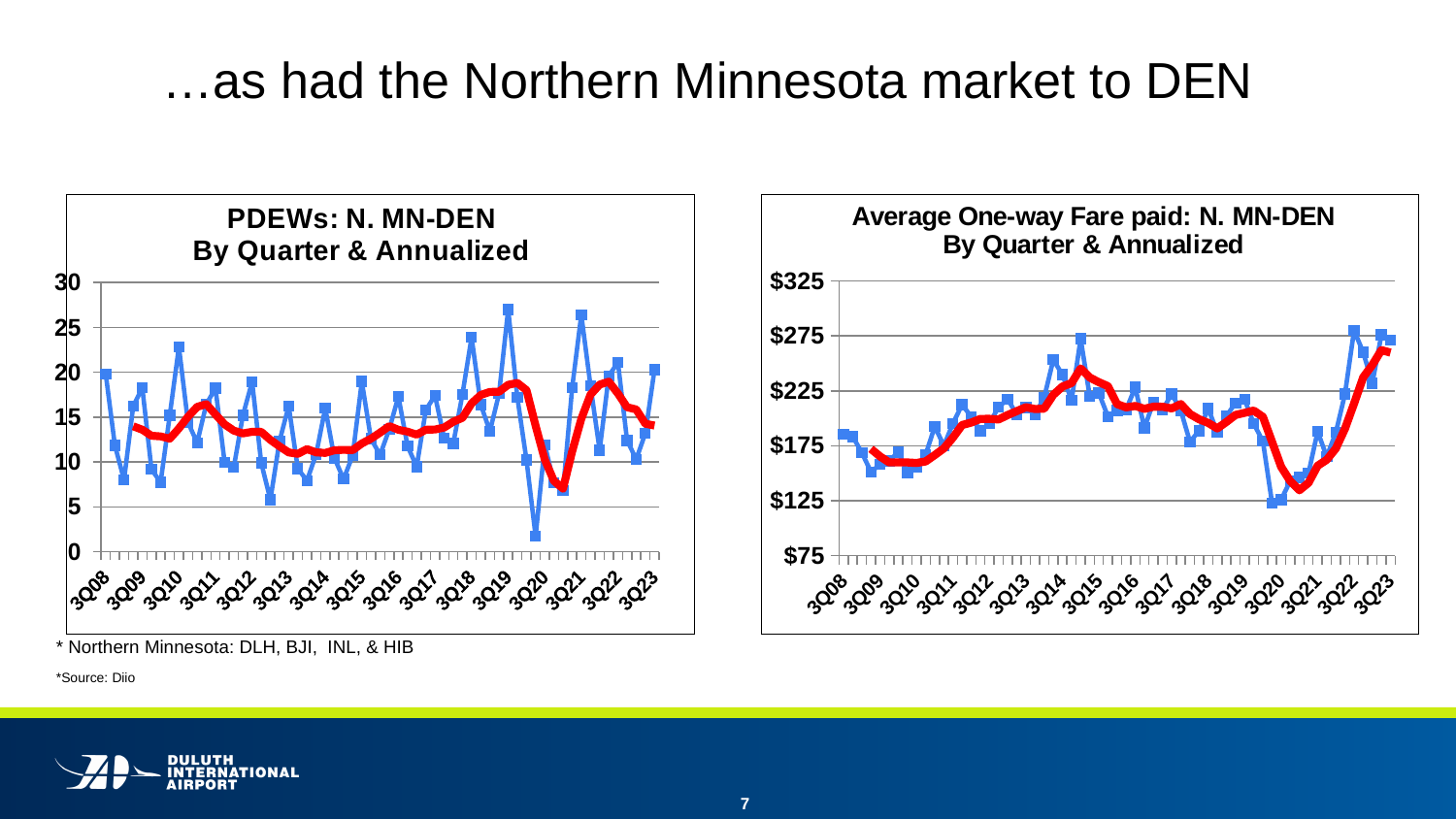
In the 'PDEWs: N. MN-DEN' chart, is the highest quarterly value greater or less than 25? greater What kind of chart is the 'PDEWs: N. MN-DEN By Quarter & Annualized' chart? line chart In the 'PDEWs: N. MN-DEN' chart, is the lowest quarterly value greater or less than 5? less In the 'Average One-way Fare paid' chart, does the fare rise or fall between 3Q20 and 3Q23? rise In the 'Average One-way Fare paid' chart, does the fare rise or fall between 3Q19 and 3Q20? fall What is the title of the chart on the right side of the slide? Average One-way Fare paid: N. MN-DEN By Quarter & Annualized In the 'Average One-way Fare paid' chart, is the highest quarterly fare greater or less than $250? greater In the 'PDEWs: N. MN-DEN' chart, how many quarter labels are shown on the x axis? 16 In the 'Average One-way Fare paid' chart, what colour is the smoothed annualized line? red